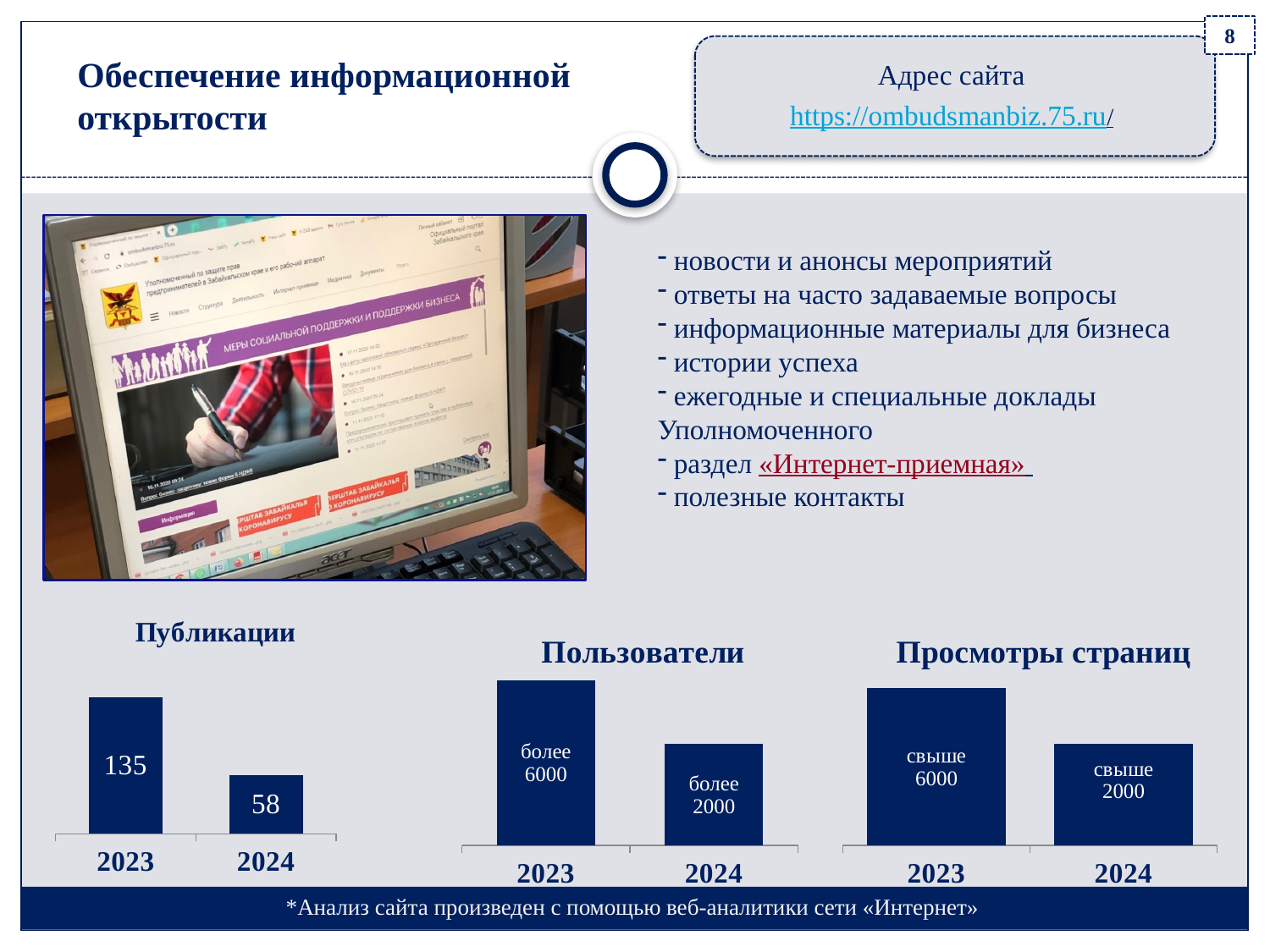
In the 'Просмотры страниц' chart, what does the data label on the 2024 bar read? свыше 2000 In the 'Публикации' chart, do the values rise or fall from 2023 to 2024? fall In the 'Просмотры страниц' chart, which year has the lowest value? 2024 In the 'Публикации' chart, what is the value for 2024? 58 In the 'Публикации' chart, what is the difference between the 2023 and 2024 values? 77 How many bar charts are shown at the bottom of the slide? 3 In the 'Пользователи' chart, which year has the larger value, 2023 or 2024? 2023 In the 'Публикации' chart, what is the value for 2023? 135 In the 'Пользователи' chart, what does the data label on the 2023 bar read? более 6000 What kind of chart is the 'Пользователи' chart? bar chart In the 'Публикации' chart, how many categories are shown on the x axis? 2 In the 'Публикации' chart, which year has the highest value? 2023